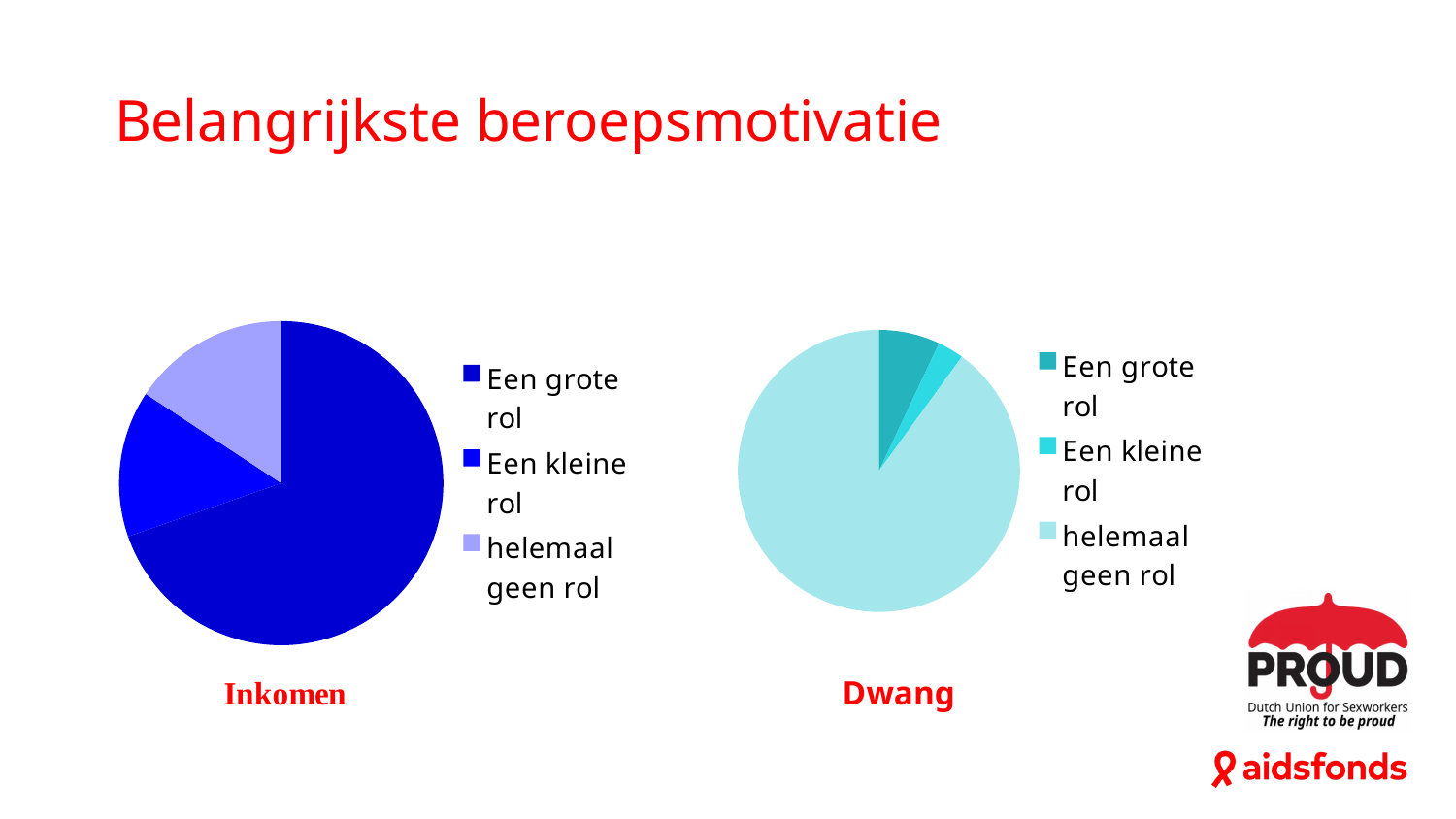
In the Dwang chart, which category has the largest slice? helemaal geen rol In the Dwang chart, which slice is larger: helemaal geen rol or Een grote rol? helemaal geen rol How many slices does the Inkomen pie chart have? 3 How many entries does the legend of the Dwang chart list? 3 In the Inkomen chart, which category has the largest slice? Een grote rol What are the titles of the two pie charts on the slide? Inkomen and Dwang What kind of chart is the Inkomen chart? pie chart In the Dwang chart, which category has the smallest slice? Een kleine rol What kind of chart is the Dwang chart? pie chart In the Dwang chart, which slice is larger: Een grote rol or Een kleine rol? Een grote rol What is the title of the slide containing the two pie charts? Belangrijkste beroepsmotivatie In the Inkomen chart, which slice is larger: Een grote rol or helemaal geen rol? Een grote rol